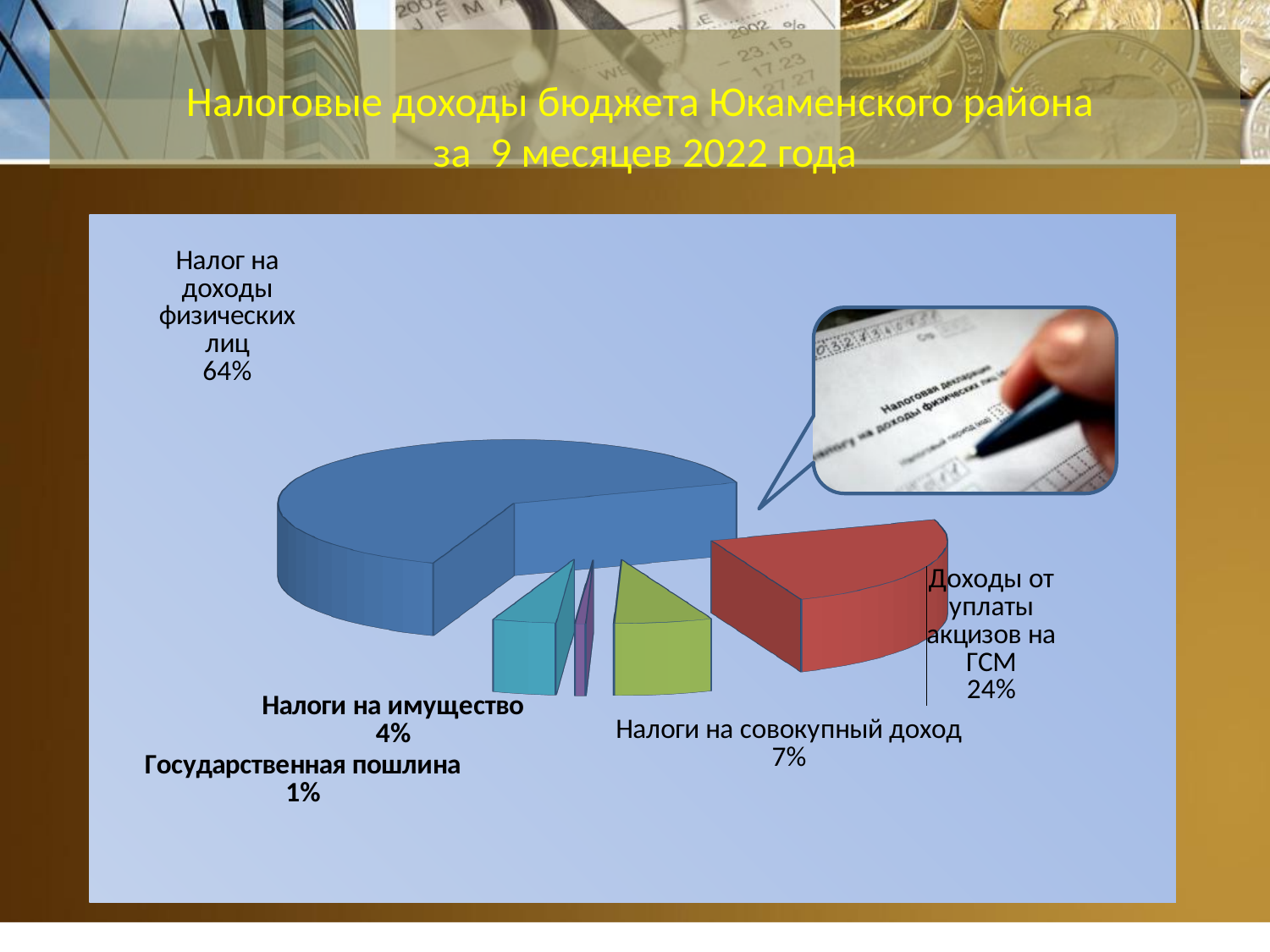
Which is larger: "Налоги на совокупный доход" or "Налоги на имущество"? Налоги на совокупный доход How many slices does the pie chart have? 5 What share of the pie does "Доходы от уплаты акцизов на ГСМ" have? 24% What is the value shown for "Государственная пошлина"? 1% What is the difference between the shares of "Налог на доходы физических лиц" and "Доходы от уплаты акцизов на ГСМ"? 40% What is the value shown for "Налоги на совокупный доход"? 7% What share of the pie does "Налог на доходы физических лиц" have? 64% Which category has the largest slice of the pie? Налог на доходы физических лиц What is the value shown for "Налоги на имущество"? 4% What kind of chart is shown on the slide? Pie chart What is the title of the slide containing the chart? Налоговые доходы бюджета Юкаменского района за 9 месяцев 2022 года Which category has the smallest slice of the pie? Государственная пошлина